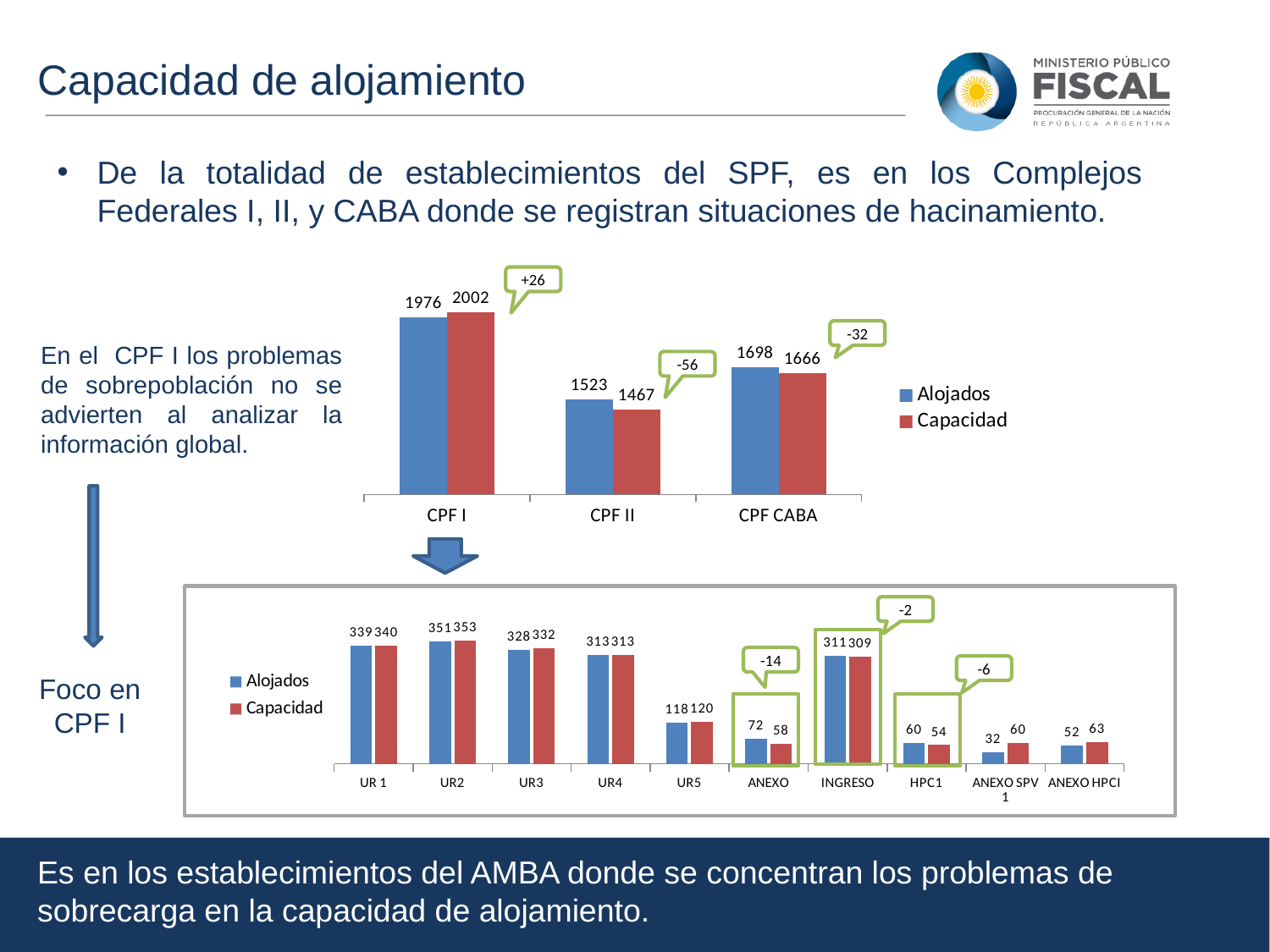
In the top chart, which category has the highest Alojados value? CPF I In the top chart, what is the Alojados value for CPF I? 1976 In the bottom chart, which category has the lowest Alojados value? ANEXO SPV 1 In the bottom chart, what is the Alojados value for ANEXO? 72 In the top chart, what is the difference between Capacidad and Alojados for CPF CABA? 32 In the top chart, what is the Capacidad value for CPF II? 1467 In the bottom chart, what is the Capacidad value for ANEXO SPV 1? 60 In the bottom chart, what is the difference between Alojados and Capacidad for INGRESO? 2 In the bottom chart, how many categories are shown on the x axis? 10 In the bottom chart, is the Alojados value for HPC1 larger or smaller than its Capacidad value? Larger What kind of chart is the top chart? Bar chart In the top chart, how many series does the legend list? 2